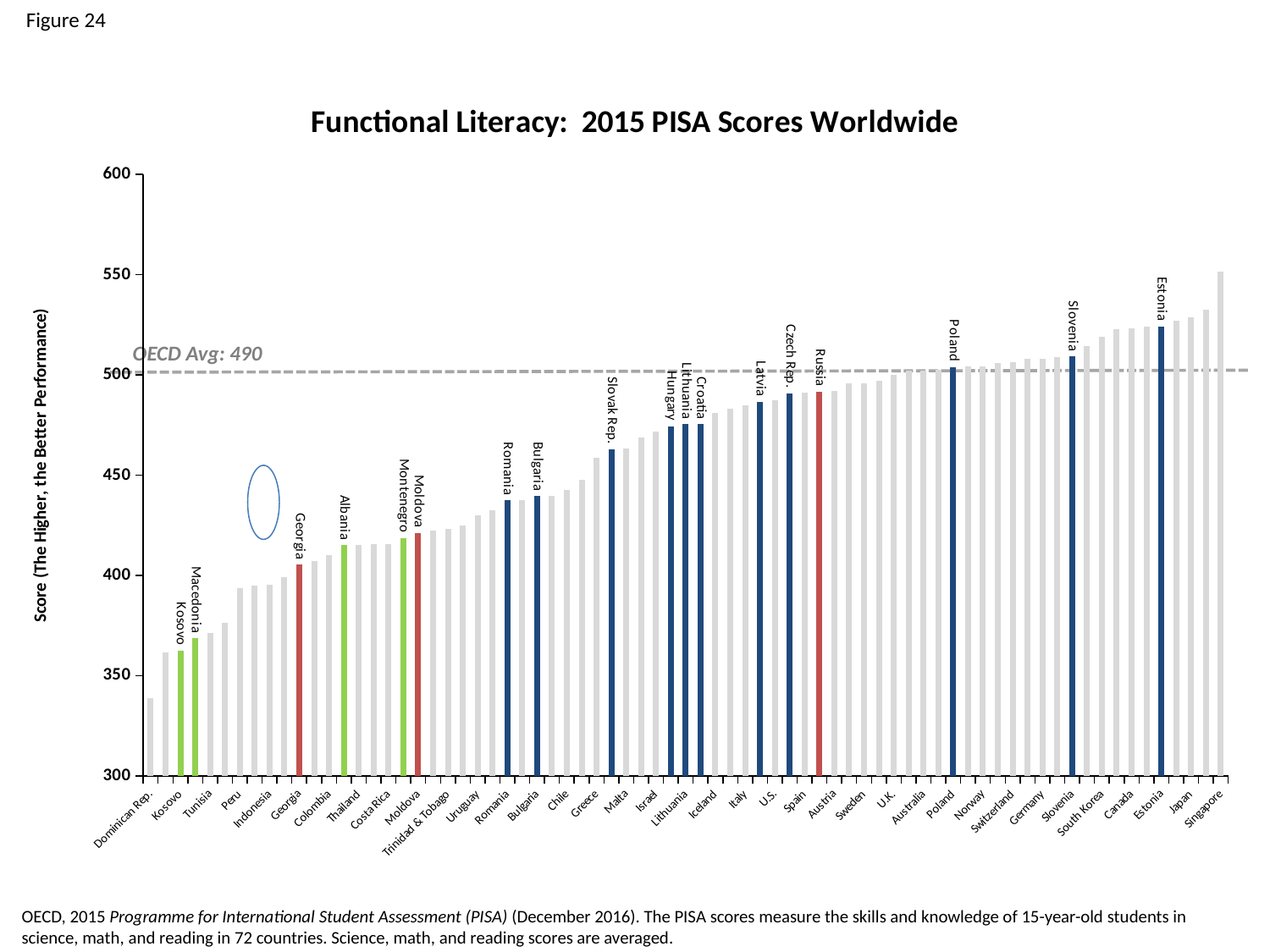
Which country has the highest 2015 PISA score on the chart? Singapore Is the PISA score for Slovak Rep. greater or less than 500? less What OECD average score is printed on the chart? 490 Do the PISA scores rise or fall moving from left to right along the x axis? rise What kind of chart is shown on the slide? bar chart Is the PISA score for Kosovo greater or less than 400? less What is the title of the chart? Functional Literacy: 2015 PISA Scores Worldwide Which has the higher PISA score, Estonia or Slovenia? Estonia Is the PISA score for Estonia greater or less than 500? greater Which country has the lowest 2015 PISA score on the chart? Dominican Rep.